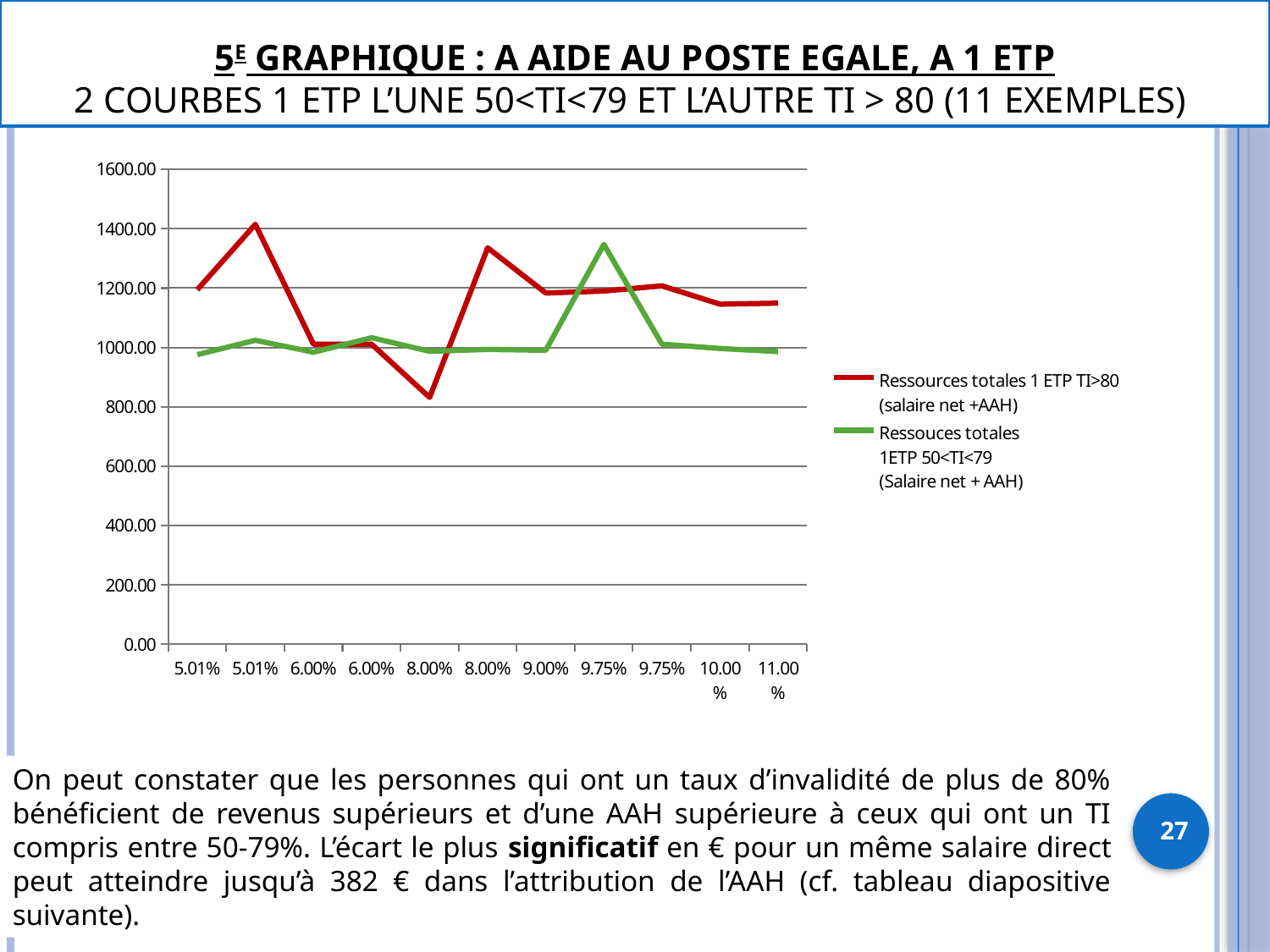
Is the value of the red series (TI>80) at the 11.00% point greater or less than 1000? greater How many series does the legend list? 2 At the first 9.75% point, which series has the larger value, the red (TI>80) or the green (50<TI<79)? green (50<TI<79) How many points are plotted along the x axis for each series? 11 What kind of chart is shown on the slide? line chart At the first 5.01% point, which series has the larger value, the red (TI>80) or the green (50<TI<79)? red (TI>80) Is the value of the red series (TI>80) at the first 8.00% point greater or less than 1000? less At which x-axis point does the red series (TI>80) reach its lowest value? the first 8.00% Which series is drawn in red? Ressources totales 1 ETP TI>80 (salaire net +AAH) At which x-axis point does the green series (50<TI<79) reach its highest value? the first 9.75% Is the value of the green series (50<TI<79) at the first 9.75% point greater or less than 1200? greater Which series is drawn in green? Ressouces totales 1ETP 50<TI<79 (Salaire net + AAH)